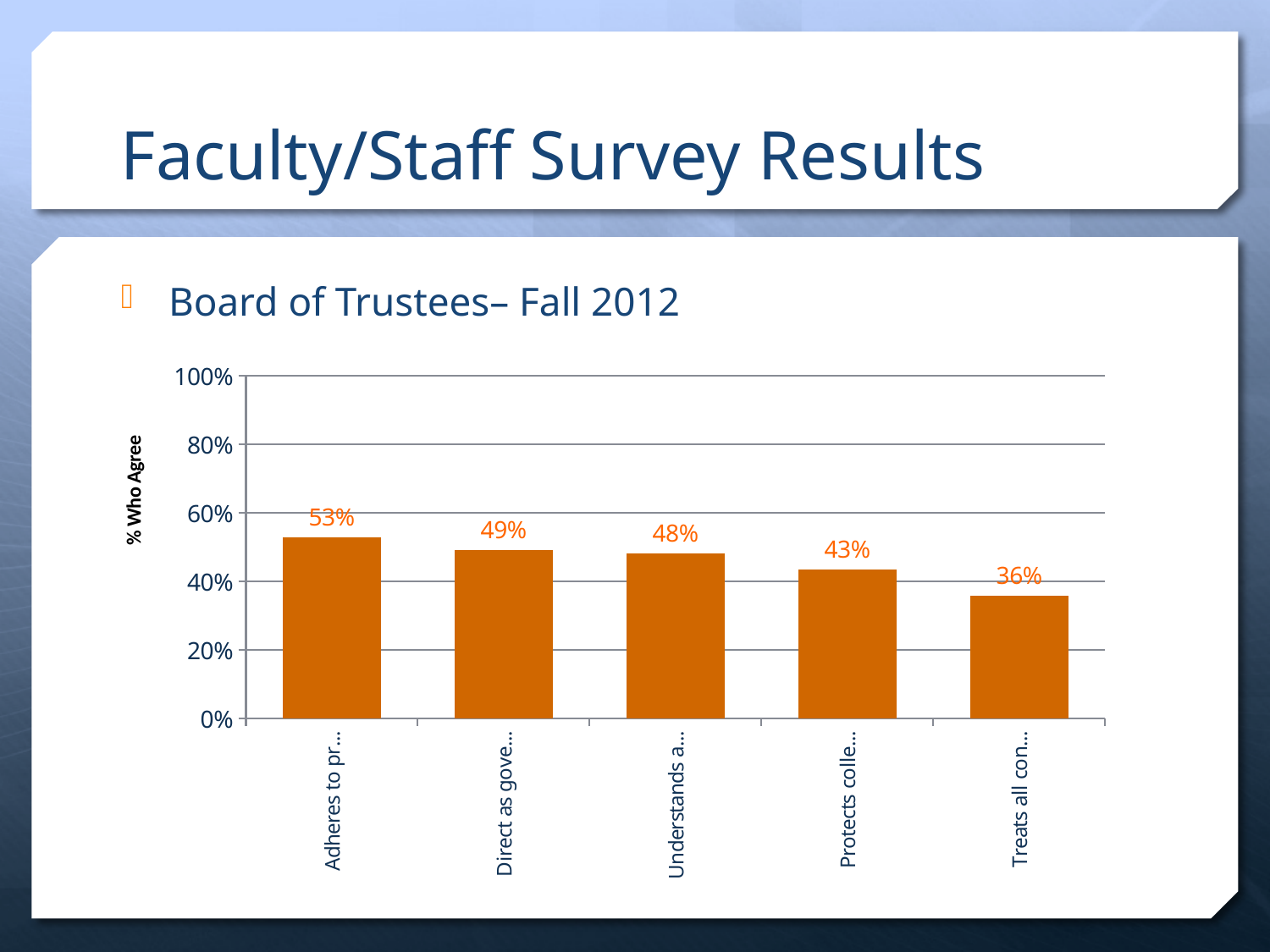
What is the value of the bar labelled "Protects colle..."? 43% Which bar has the highest value? Adheres to pr... Do the bar values rise or fall from left to right along the x axis? fall What is the value of the bar labelled "Understands a..."? 48% What is the label of the vertical axis? % Who Agree What type of chart is shown on the slide? bar chart What is the difference between the first bar (53%) and the last bar (36%)? 17% What is the value of the bar labelled "Direct as gove..."? 49% What is the value of the first bar, labelled "Adheres to pr..."? 53% Which bar has the lowest value? Treats all con... What is the value of the last bar, labelled "Treats all con..."? 36% How many bars are plotted in the chart? 5